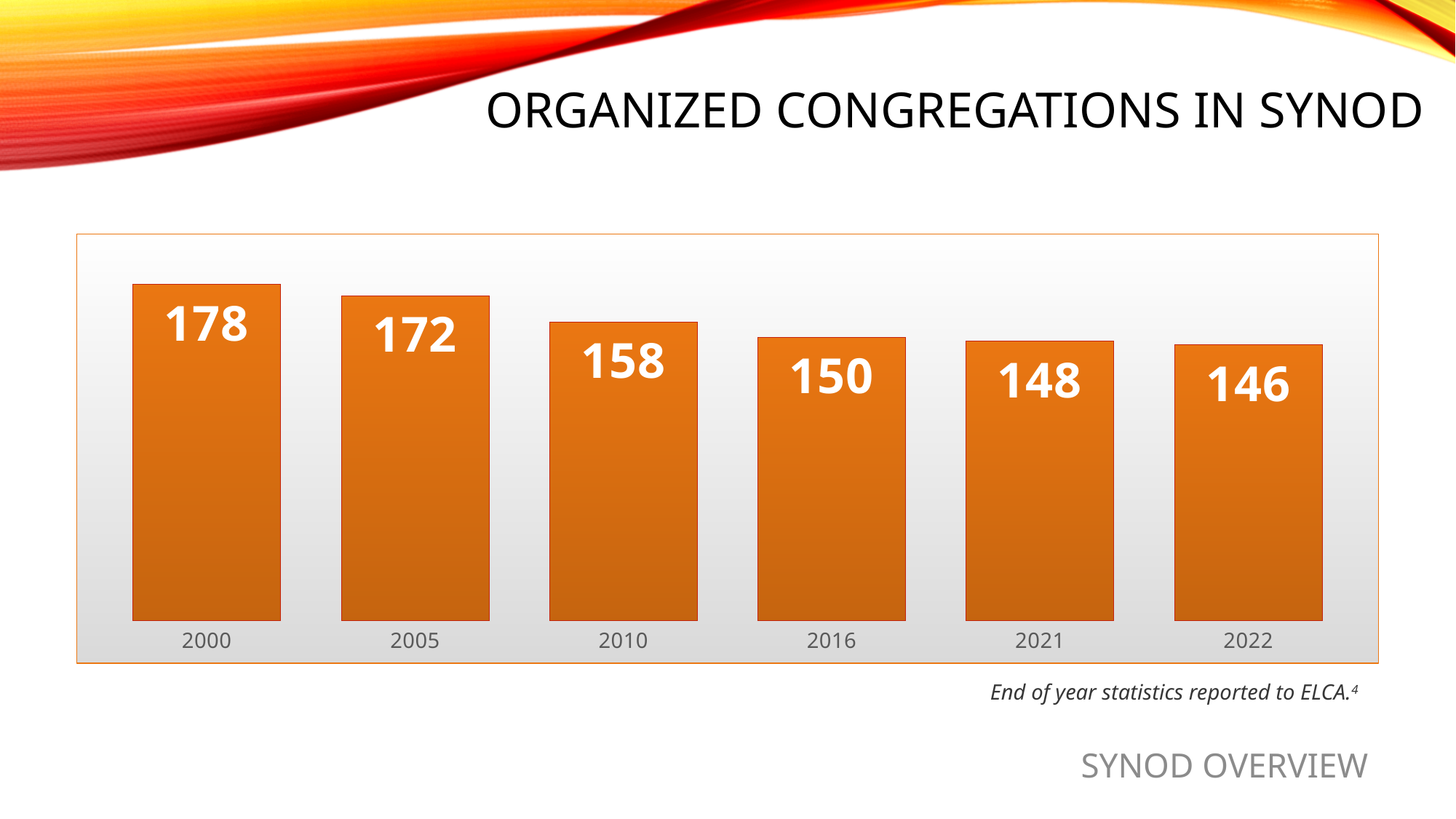
Do the values rise or fall from 2000 to 2022? Fall How many years are shown on the chart? 6 What kind of chart is shown on the slide? Bar chart How many organized congregations were in the synod in 2000? 178 Which year has the highest number of organized congregations? 2000 What is the value shown for 2010? 158 What is the difference between the values for 2005 and 2010? 14 What is the title of the chart on the slide? Organized Congregations in Synod What is the difference between the values for 2000 and 2022? 32 Which is larger, the value for 2016 or the value for 2021? 2016 What is the value shown for 2022? 146 Which year has the lowest number of organized congregations? 2022